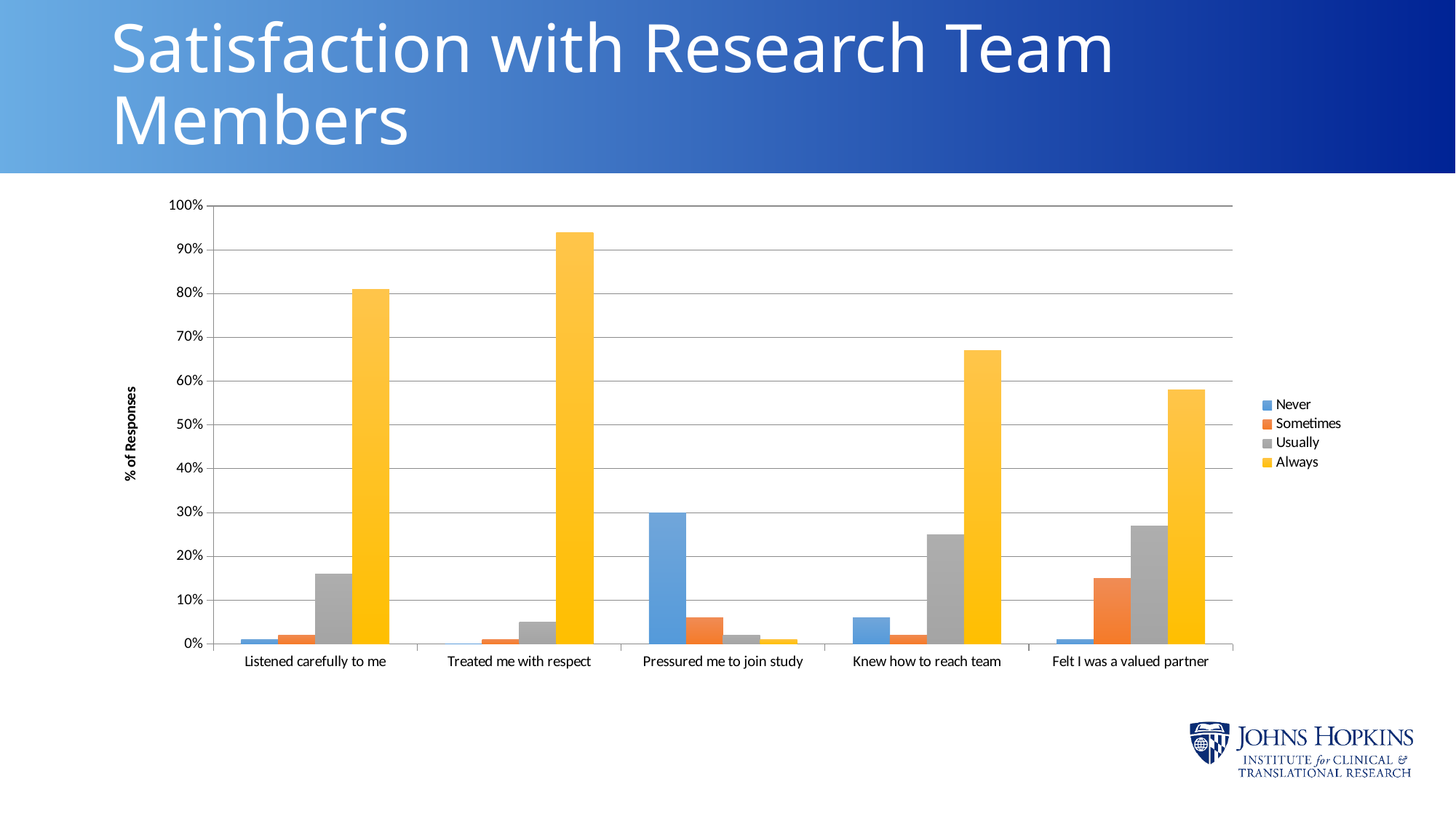
Is the 'Usually' value for 'Knew how to reach team' greater or less than 20%? greater How many categories are shown along the x axis of the chart? 5 How many series does the chart's legend list? 4 Which category has the lowest 'Always' value? Pressured me to join study Which category has the highest 'Never' value? Pressured me to join study Which is larger, the 'Always' value for 'Listened carefully to me' or the 'Always' value for 'Knew how to reach team'? Listened carefully to me Which is larger, the 'Sometimes' value for 'Felt I was a valued partner' or the 'Sometimes' value for 'Pressured me to join study'? Felt I was a valued partner Which category has the highest 'Always' value? Treated me with respect Is the 'Always' value for 'Treated me with respect' greater or less than 90%? greater Is the 'Always' value for 'Felt I was a valued partner' greater or less than 50%? greater What kind of chart is shown on the slide? bar chart What is the label of the chart's vertical axis? % of Responses